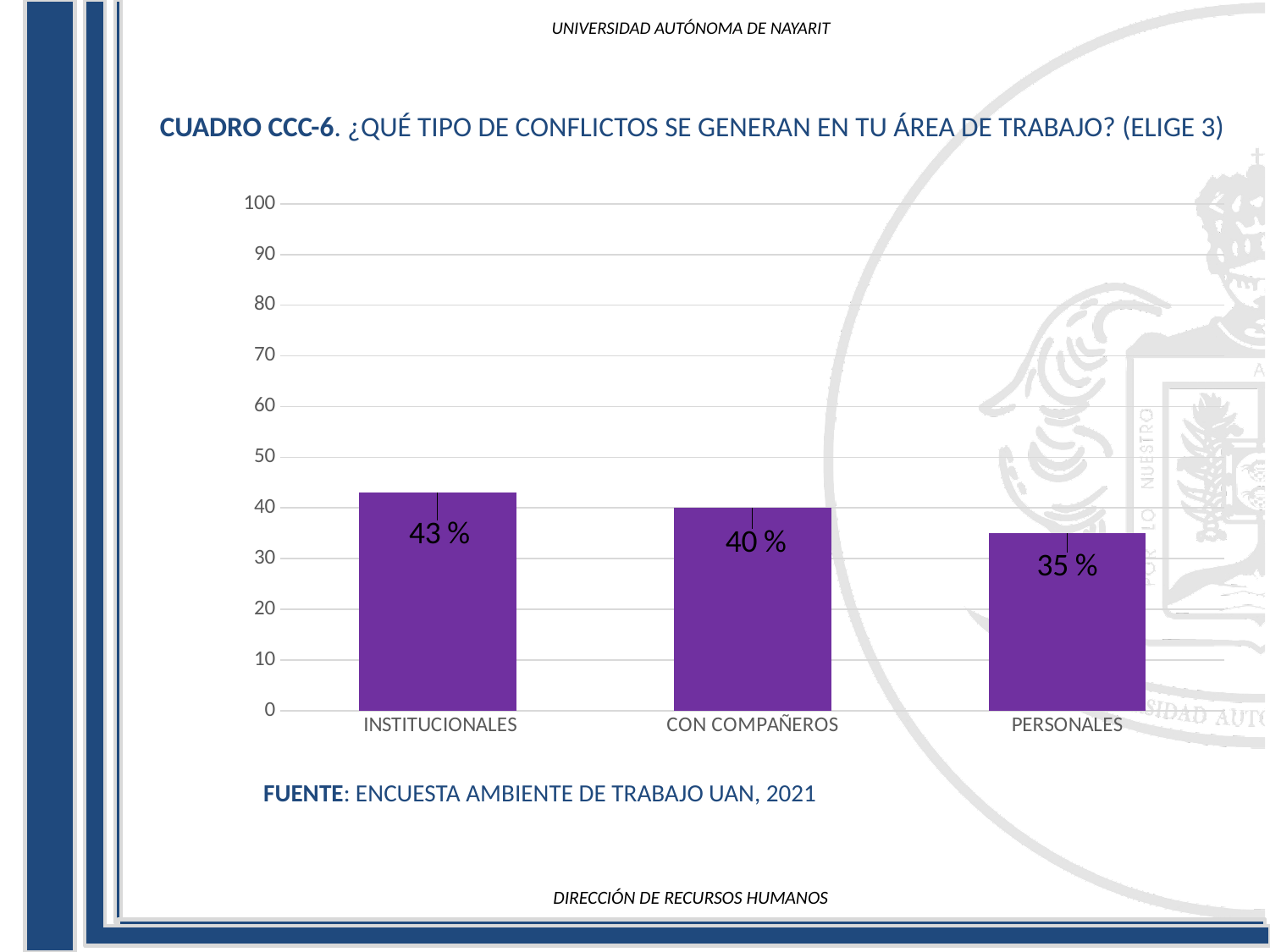
What is the value for CON COMPAÑEROS? 40 % Which category has the lowest value? PERSONALES How many categories are shown in the chart? 3 What is the difference between the values for INSTITUCIONALES and PERSONALES? 8 % Which category has the highest value? INSTITUCIONALES Which is larger, the value for INSTITUCIONALES or the value for CON COMPAÑEROS? INSTITUCIONALES What is the difference between the values for CON COMPAÑEROS and PERSONALES? 5 % What is the value for PERSONALES? 35 % What kind of chart is shown on the slide? bar chart Do the values rise or fall from left to right along the x axis? fall Is the value for PERSONALES greater or less than 40? less What is the value for INSTITUCIONALES? 43 %